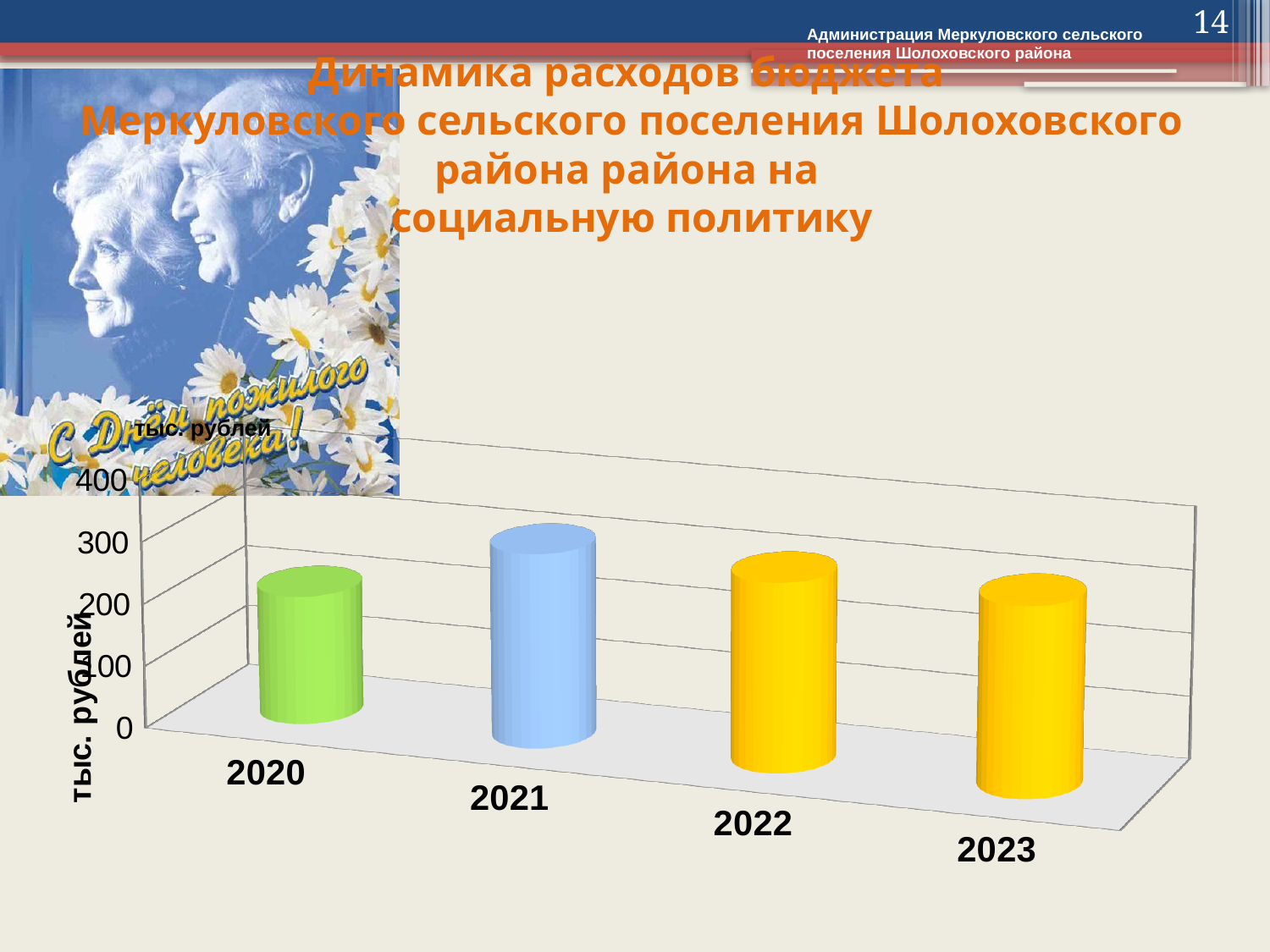
Is the value for 2021 greater or less than 200? greater What kind of chart is shown on the slide? Bar chart Which is larger, the value for 2020 or the value for 2021? 2021 What unit is shown on the vertical axis of the chart? тыс. рублей Which year has the lowest value in the chart? 2020 What is the highest tick value shown on the vertical axis? 400 How many years are shown on the x axis of the chart? 4 Is the value for 2020 greater or less than 100? greater Is the value for 2023 greater or less than 100? greater